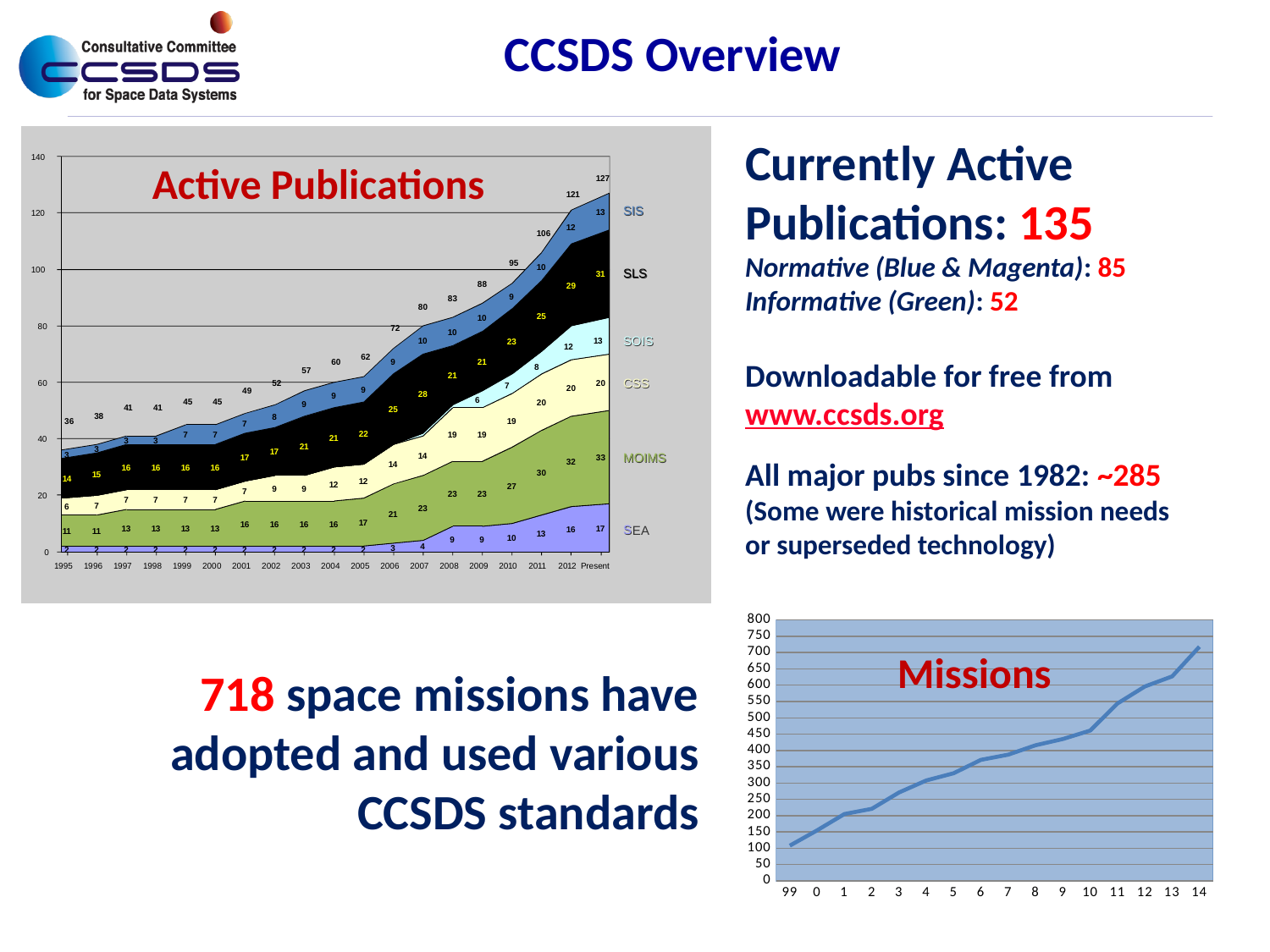
In the Active Publications chart, what is the SEA value at Present? 17 In the Missions chart, is the value at 10 greater or less than 400? greater In the Active Publications chart, which year has the lowest total of active publications? 1995 In the Active Publications chart, by how much does the total at Present exceed the total for 2012? 6 In the Active Publications chart, what is the MOIMS value for 2012? 32 How many series does the Active Publications chart show in its legend? 6 What kind of chart is the Missions chart? line chart In the Active Publications chart, what is the total number of active publications shown for Present? 127 In the Missions chart, do the values rise or fall along the x axis? rise In the Active Publications chart, what is the total number of active publications shown for 1995? 36 In the Active Publications chart, what is the SLS value at Present? 31 In the Missions chart, is the value at 14 greater or less than 650? greater